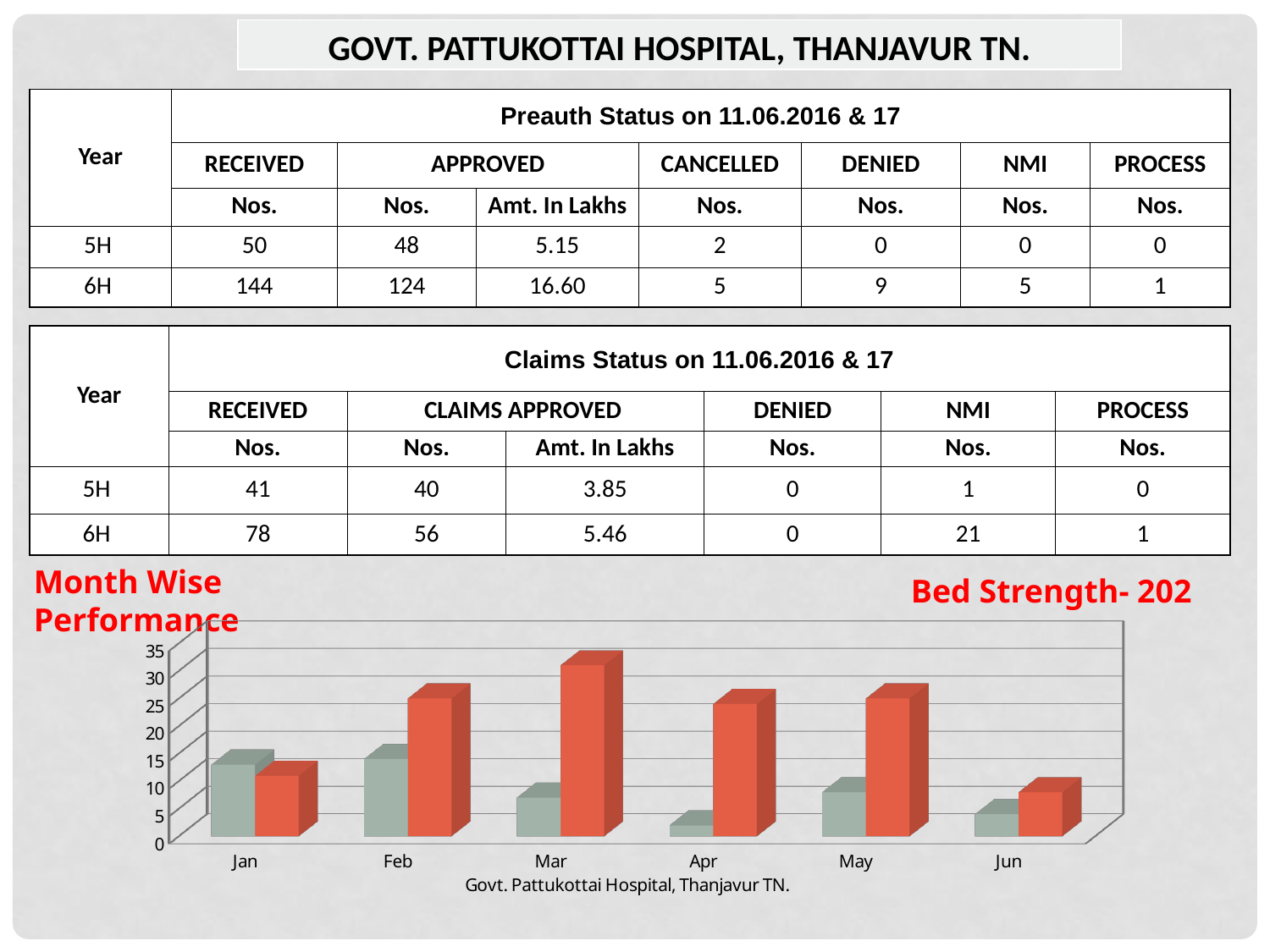
What text appears below the x axis of the Month Wise Performance chart? Govt. Pattukottai Hospital, Thanjavur TN. In the Month Wise Performance chart, is the red bar for Mar greater or less than 25? greater In the Month Wise Performance chart, which month has the tallest red bar? Mar In the Month Wise Performance chart, which is larger for Mar: the red bar or the grey bar? the red bar How many bars are plotted for each month in the Month Wise Performance chart? 2 In the Month Wise Performance chart, is the grey bar for Apr greater or less than 5? less In the Month Wise Performance chart, is the red bar for Feb greater or less than 20? greater In the Month Wise Performance chart, which is larger: the red bar for Mar or the red bar for Apr? Mar How many months are shown on the x axis of the Month Wise Performance chart? 6 What kind of chart is shown under the heading 'Month Wise Performance'? bar chart In the Month Wise Performance chart, which month has the shortest grey bar? Apr